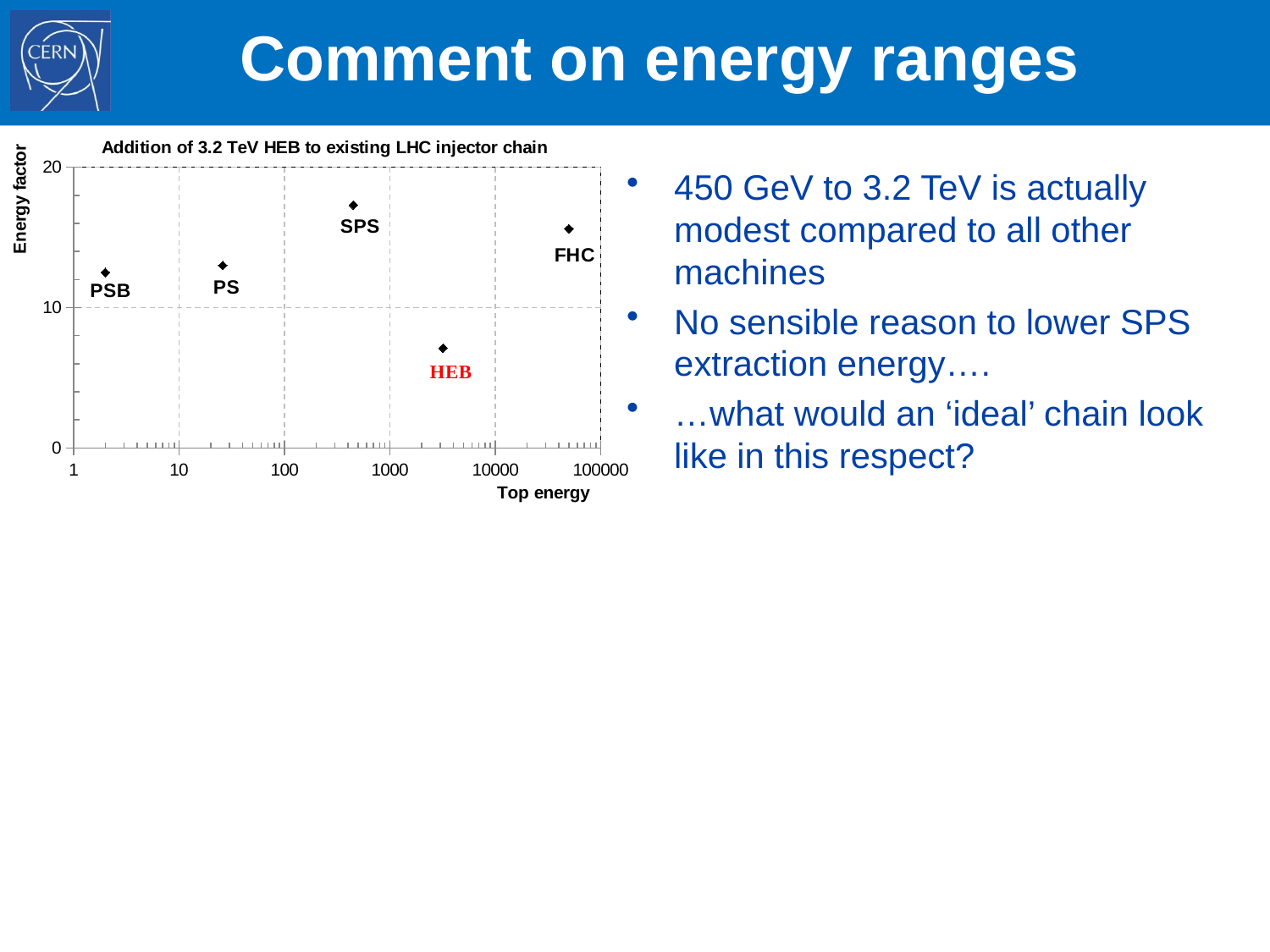
How many machines are plotted as points on the chart? 5 Is the energy factor for PSB greater or less than 10? greater What kind of chart is shown on the slide? Scatter chart Which machine has the highest energy factor? SPS Is the energy factor for FHC greater or less than 20? less Which machine has the lowest energy factor? HEB Is the energy factor for HEB greater or less than 10? less What is the title of the chart? Addition of 3.2 TeV HEB to existing LHC injector chain Which has the larger energy factor, SPS or HEB? SPS Which has the larger energy factor, FHC or HEB? FHC What is the label of the horizontal axis of the chart? Top energy